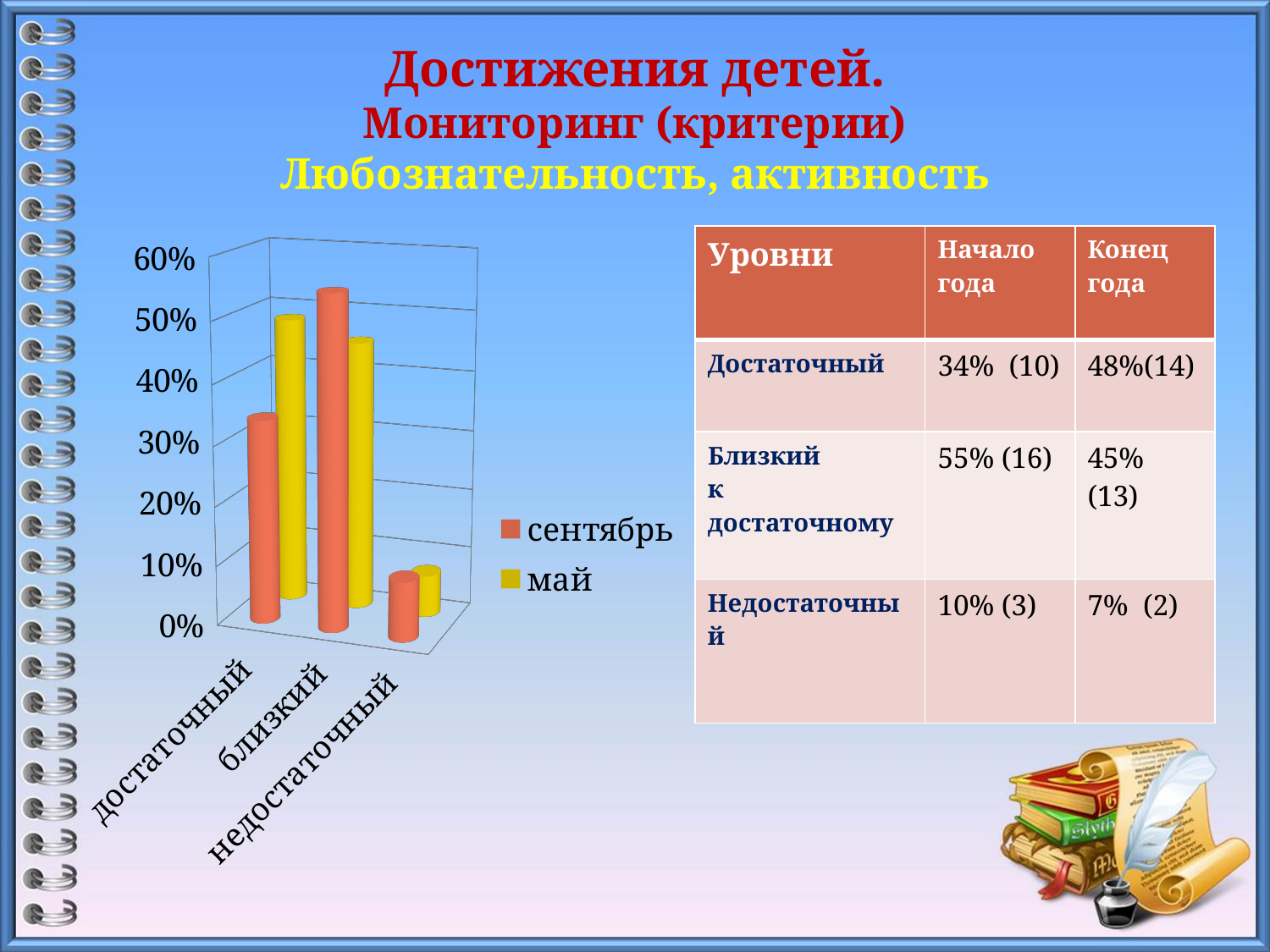
For достаточный, which is larger: the сентябрь bar or the май bar? май Is the сентябрь value for близкий greater or less than 50%? greater Is the май value for достаточный greater or less than 40%? greater How many series does the chart legend list? 2 Which series is shown in yellow in the chart legend? май Which category has the highest bar for сентябрь? близкий What kind of chart is shown on the slide? bar chart Which category has the lowest bar for май? недостаточный For близкий, which is larger: the сентябрь bar or the май bar? сентябрь Is the сентябрь value for недостаточный greater or less than 20%? less According to the table on the slide, what is the value for Достаточный at the start of the year (Начало года)? 34% (10) How many categories are shown on the chart's x axis? 3